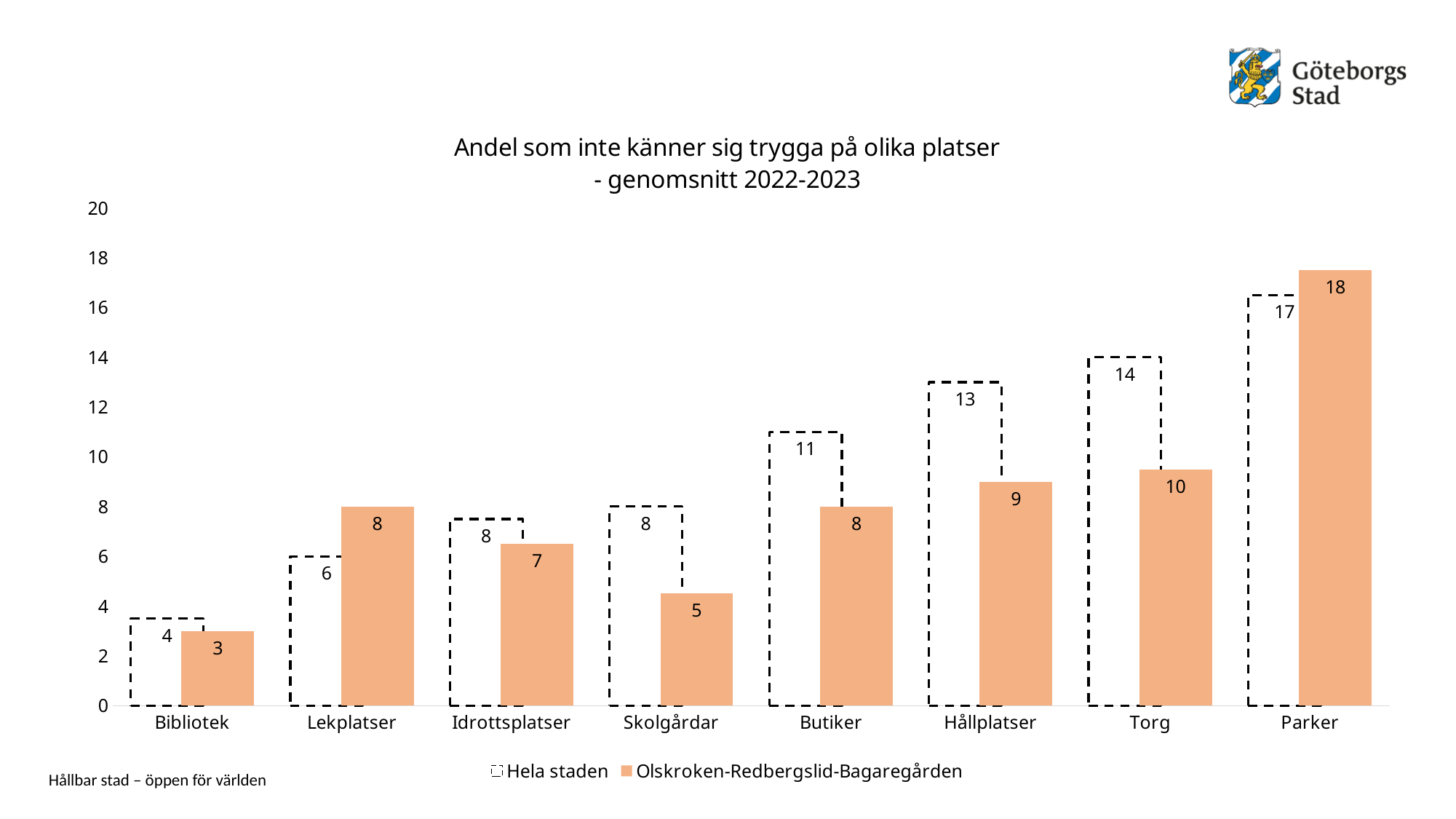
What is the value for Olskroken-Redbergslid-Bagaregården at Skolgårdar? 5 What is the value for Hela staden at Butiker? 11 Which series has the larger value at Lekplatser, Hela staden or Olskroken-Redbergslid-Bagaregården? Olskroken-Redbergslid-Bagaregården How many series does the legend list? 2 What is the difference between Hela staden and Olskroken-Redbergslid-Bagaregården at Torg? 4 What kind of chart is shown on the slide? bar chart Which category has the lowest value for Olskroken-Redbergslid-Bagaregården? Bibliotek What is the title of the chart? Andel som inte känner sig trygga på olika platser - genomsnitt 2022-2023 How many categories are shown on the x axis? 8 Is the value for Olskroken-Redbergslid-Bagaregården at Hållplatser greater or less than 12? less What is the value for Olskroken-Redbergslid-Bagaregården at Parker? 18 Which category has the highest value for Hela staden? Parker